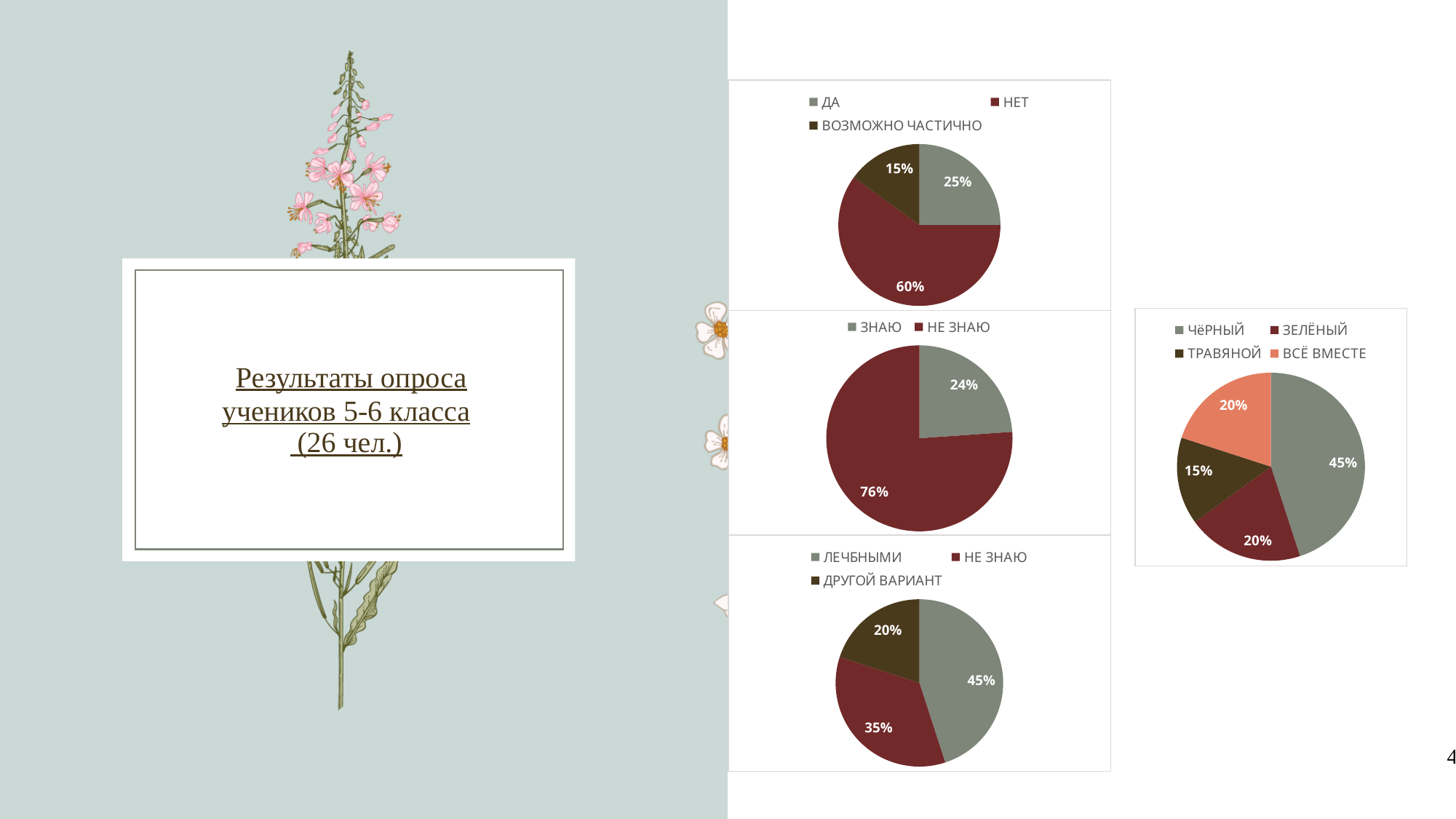
In the top pie chart in the middle column, which category has the largest slice? НЕТ In the top pie chart in the middle column (legend ДА / НЕТ / ВОЗМОЖНО ЧАСТИЧНО), what share is labelled for НЕТ? 60% In the bottom pie chart of the middle column (legend ЛЕЧБНЫМИ / НЕ ЗНАЮ / ДРУГОЙ ВАРИАНТ), what share is labelled for ЛЕЧБНЫМИ? 45% In the bottom pie chart of the middle column, which category has the smallest slice? ДРУГОЙ ВАРИАНТ In the middle pie chart of the middle column (legend ЗНАЮ / НЕ ЗНАЮ), what share is labelled for НЕ ЗНАЮ? 76% What type of chart is the chart on the right of the slide? Pie chart In the top pie chart in the middle column, what share is labelled for ВОЗМОЖНО ЧАСТИЧНО? 15% In the top pie chart in the middle column, what is the difference in percentage points between ДА and ВОЗМОЖНО ЧАСТИЧНО? 10 percentage points In the middle pie chart of the middle column, how many categories does the legend list? 2 In the pie chart on the right of the slide (legend ЧёРНЫЙ / ЗЕЛЁНЫЙ / ТРАВЯНОЙ / ВСЁ ВМЕСТЕ), what share is labelled for ЧёРНЫЙ? 45% In the pie chart on the right of the slide, how many categories does the legend list? 4 In the bottom pie chart of the middle column, which is larger: ЛЕЧБНЫМИ or НЕ ЗНАЮ? ЛЕЧБНЫМИ